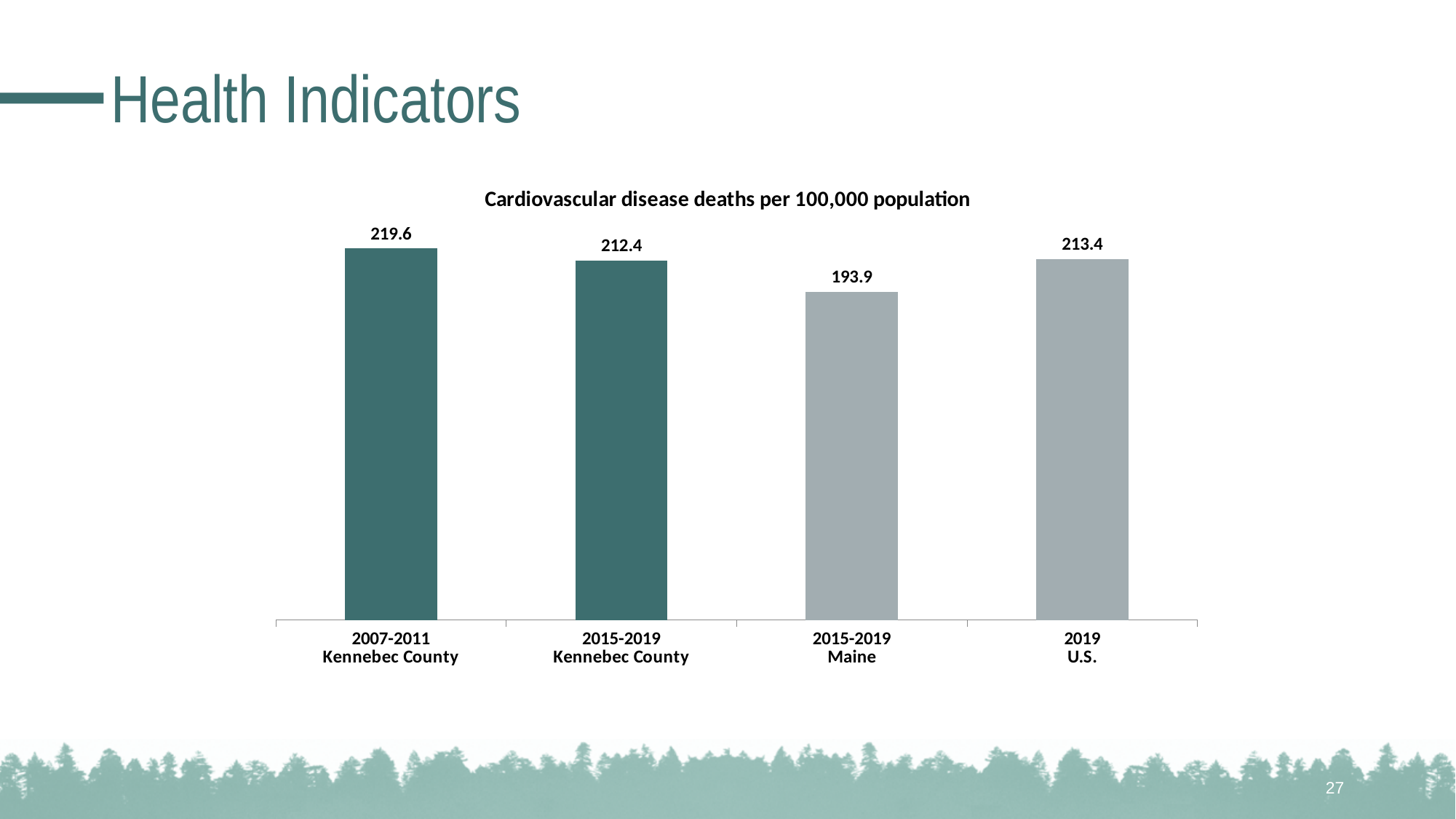
What is the title of the chart? Cardiovascular disease deaths per 100,000 population Which category has the highest cardiovascular disease death rate? 2007-2011 Kennebec County How many bars are shown in the chart? 4 By how much did the cardiovascular disease death rate for Kennebec County fall from 2007-2011 to 2015-2019? 7.2 What is the cardiovascular disease death rate per 100,000 population for Kennebec County in 2007-2011? 219.6 What is the cardiovascular disease death rate per 100,000 population for Kennebec County in 2015-2019? 212.4 What is the cardiovascular disease death rate per 100,000 population for the U.S. in 2019? 213.4 What is the cardiovascular disease death rate per 100,000 population for Maine in 2015-2019? 193.9 Which is larger, the 2015-2019 Kennebec County rate or the 2015-2019 Maine rate? 2015-2019 Kennebec County What is the difference between the 2019 U.S. rate and the 2015-2019 Maine rate? 19.5 What kind of chart is shown on the slide? Bar chart Which category has the lowest cardiovascular disease death rate? 2015-2019 Maine